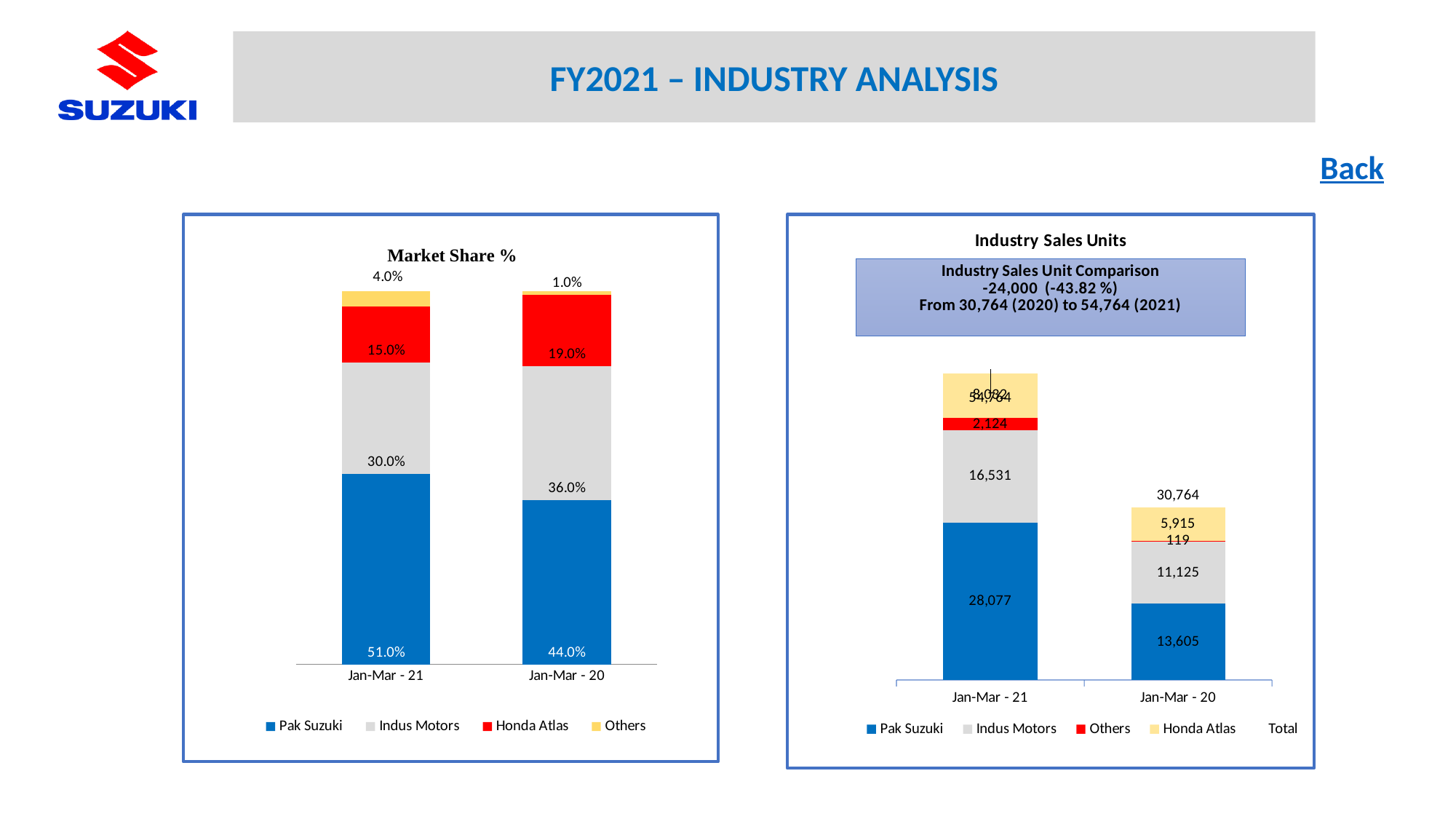
In the Market Share % chart, by how many percentage points does Pak Suzuki's share in Jan-Mar - 21 exceed its share in Jan-Mar - 20? 7.0 percentage points In the Market Share % chart, is the Indus Motors share larger in Jan-Mar - 21 or Jan-Mar - 20? Jan-Mar - 20 What kind of chart is the Market Share % chart? Stacked bar chart In the Industry Sales Units chart, which series has the smallest value in the Jan-Mar - 20 bar? Others How many categories are shown on the x axis of the Industry Sales Units chart? 2 In the Market Share % chart, what is the value for Pak Suzuki in Jan-Mar - 21? 51.0% In the Market Share % chart, what is the value for Honda Atlas in Jan-Mar - 20? 19.0% In the Industry Sales Units chart, what is the difference between Pak Suzuki's units in Jan-Mar - 21 and Jan-Mar - 20? 14,472 How many series does the legend of the Market Share % chart list? 4 In the Industry Sales Units chart, what is the value for Pak Suzuki in Jan-Mar - 21? 28,077 In the Industry Sales Units chart, what is the total for the Jan-Mar - 20 bar? 30,764 In the Industry Sales Units chart, what is the value for Indus Motors in Jan-Mar - 20? 11,125